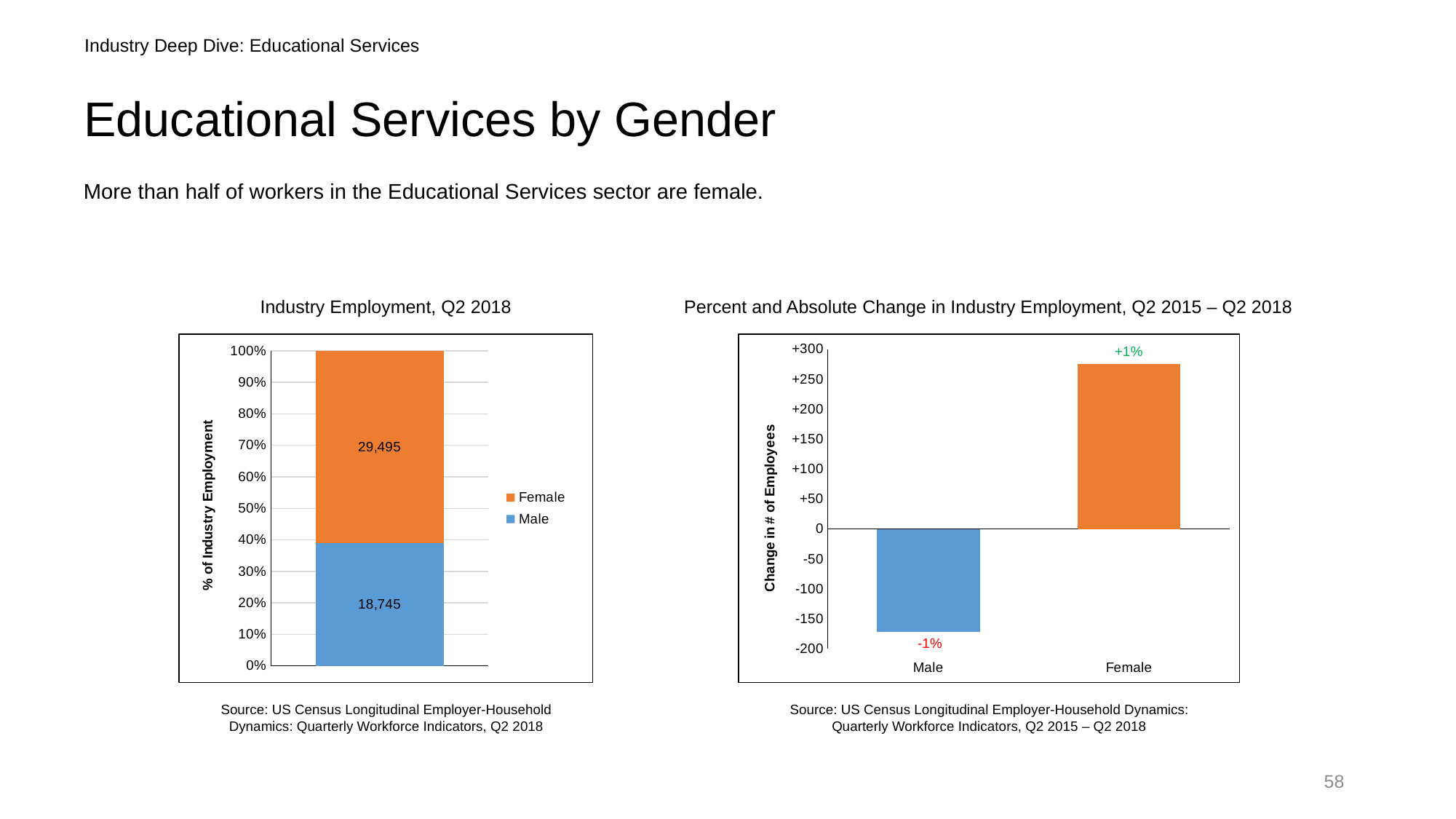
In the 'Industry Employment, Q2 2018' chart, what is the difference between the Female and Male values? 10,750 In the 'Industry Employment, Q2 2018' chart, what is the total of the stacked bar? 48,240 In the 'Industry Employment, Q2 2018' chart, which group has the larger value, Female or Male? Female In the 'Percent and Absolute Change in Industry Employment, Q2 2015 – Q2 2018' chart, what percent change is labelled for Male? -1% In the 'Industry Employment, Q2 2018' chart, what is the value shown for Female? 29,495 In the 'Industry Employment, Q2 2018' chart, what is the value shown for Male? 18,745 In the 'Percent and Absolute Change in Industry Employment, Q2 2015 – Q2 2018' chart, what percent change is labelled for Female? +1% How many series does the legend of the 'Industry Employment, Q2 2018' chart list? 2 In the 'Percent and Absolute Change in Industry Employment, Q2 2015 – Q2 2018' chart, is the change in number of employees for Male greater or less than -150? less In the 'Percent and Absolute Change in Industry Employment, Q2 2015 – Q2 2018' chart, which category shows the lowest change in number of employees? Male What kind of chart is the 'Industry Employment, Q2 2018' chart? Stacked bar chart In the 'Percent and Absolute Change in Industry Employment, Q2 2015 – Q2 2018' chart, is the change in number of employees for Female greater or less than +250? greater